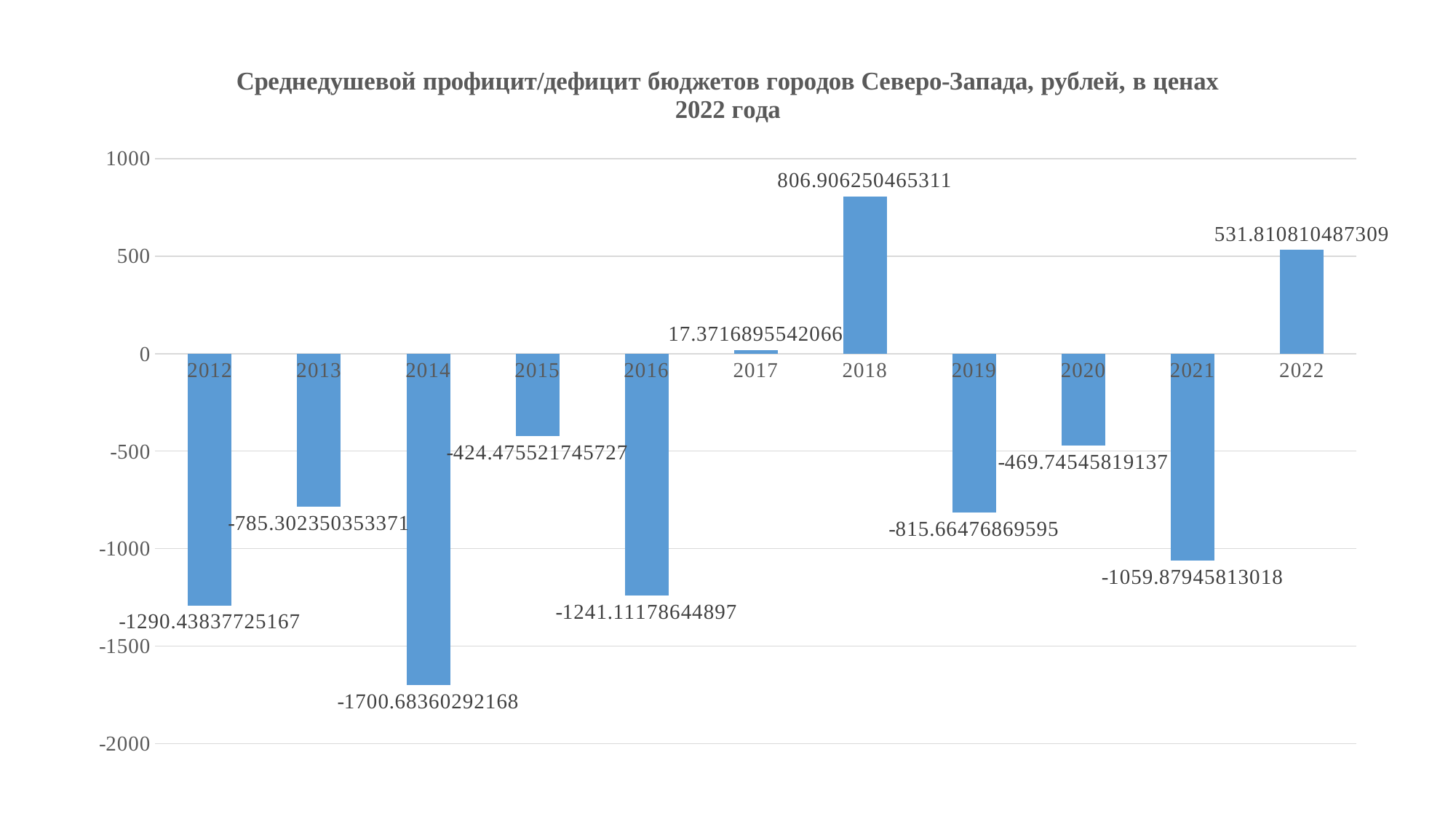
What is the value for 2014? -1700.68360292168 How many years have a positive value? 3 Which year has the highest value? 2018 Is the value for 2021 greater or less than -1000? less What kind of chart is this? bar chart What is the value for 2022? 531.810810487309 Which is larger, the value for 2013 or the value for 2019? 2013 How many years are shown on the x axis? 11 What is the value for 2017? 17.3716895542066 What is the difference between the values for 2018 and 2022? 275.095439978002 Which year has the lowest value? 2014 What is the value for 2018? 806.906250465311